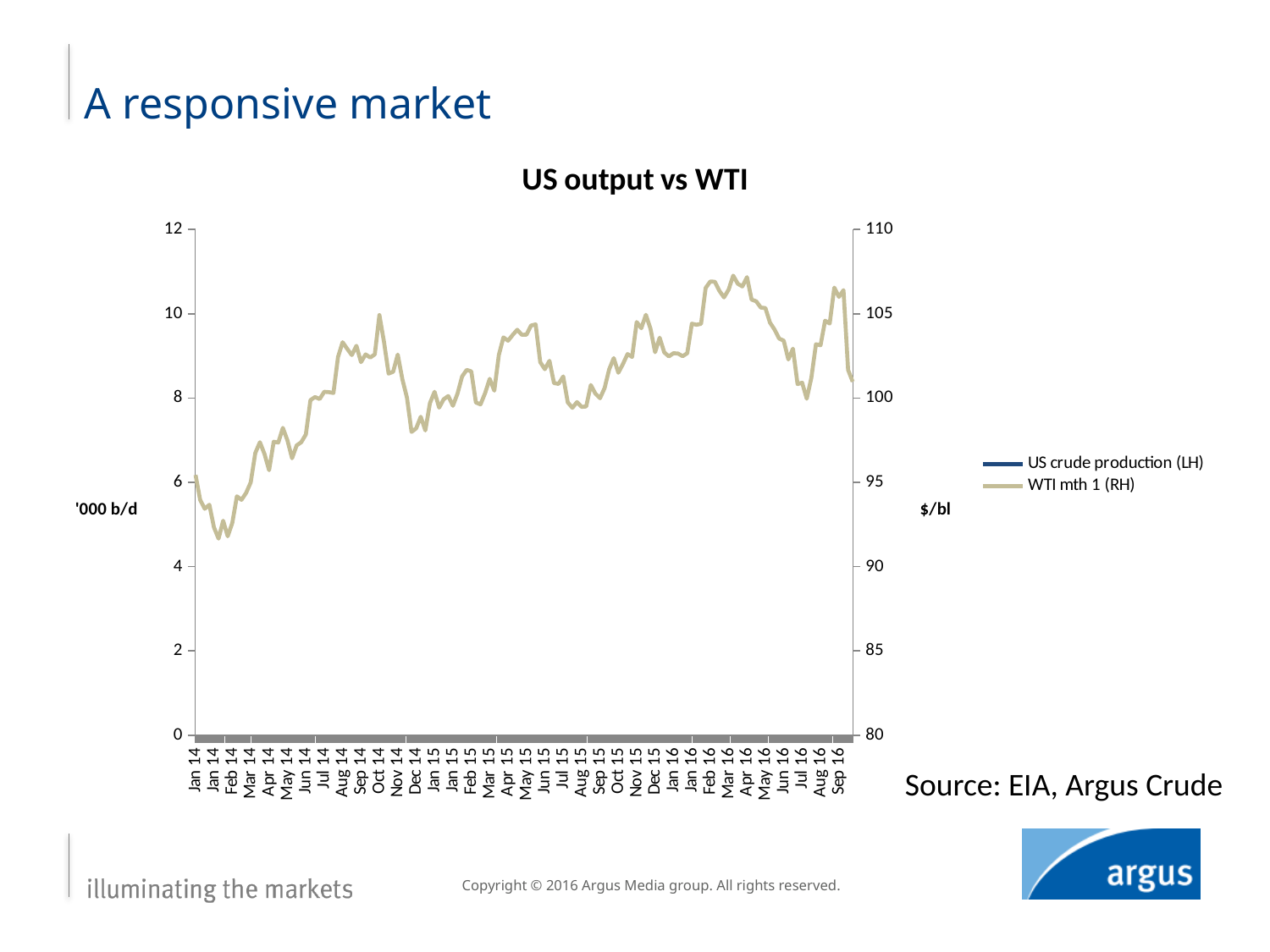
Is the WTI mth 1 value around Dec 14 greater or less than 100 $/bl? less Is the WTI mth 1 value around Apr 16 greater or less than 105 $/bl? greater Does the WTI mth 1 line rise or fall overall between Feb 14 and Oct 14? rise What is the title of the chart? US output vs WTI Is the WTI mth 1 value around Jan 14 greater or less than 100 $/bl? less What kind of chart is shown on the slide? line chart Which series is plotted on the right-hand axis according to the legend? WTI mth 1 (RH) Does the WTI mth 1 line rise or fall overall between Apr 16 and Jul 16? fall How many series does the legend list? 2